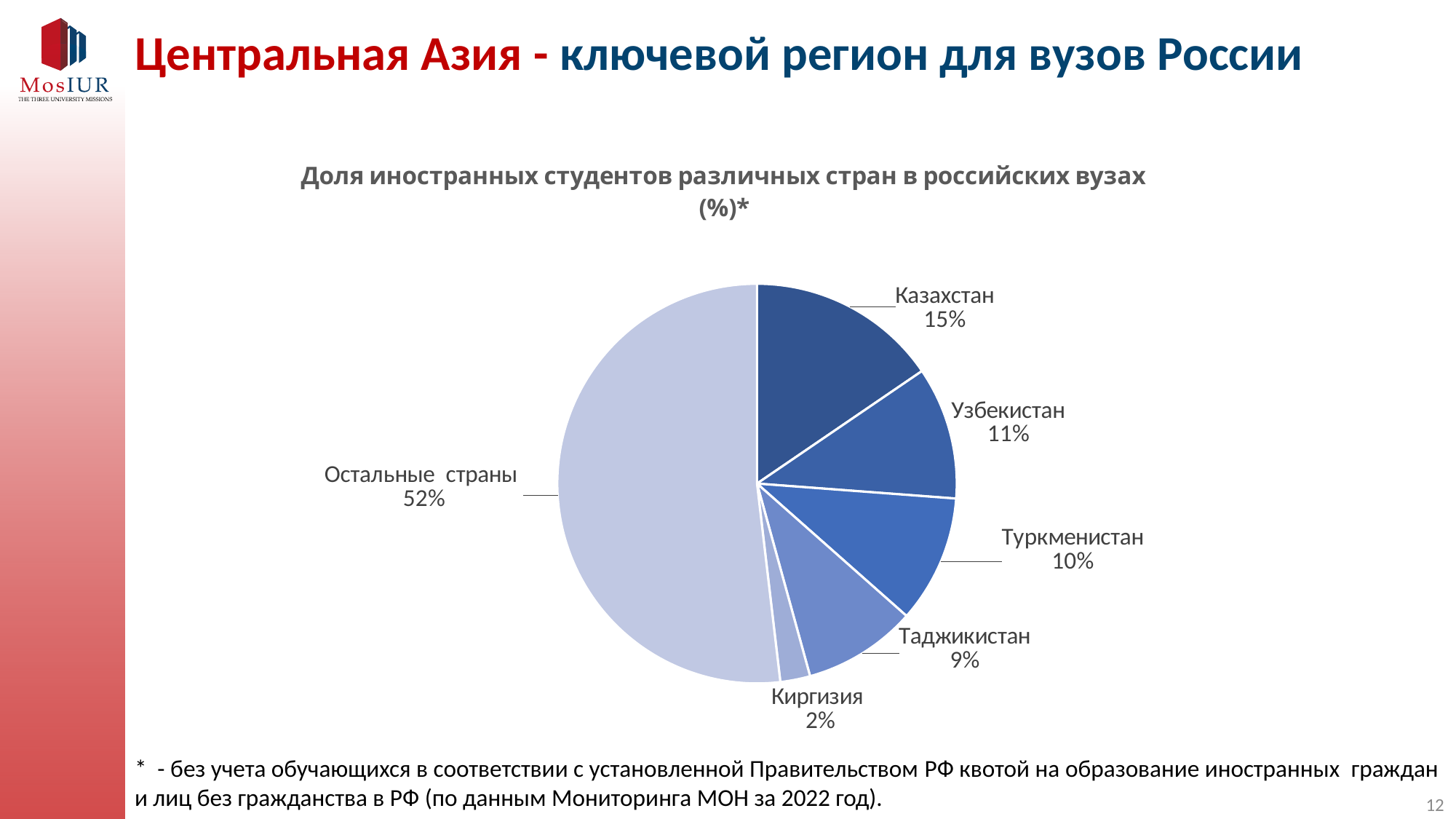
What is the value shown for Туркменистан? 10% Which category has the largest slice of the pie? Остальные страны What kind of chart is shown on the slide? Pie chart How many slices does the pie chart have? 6 Which category has the smallest slice of the pie? Киргизия Which is larger, the share of Узбекистан or the share of Туркменистан? Узбекистан What is the title of the chart? Доля иностранных студентов различных стран в российских вузах (%)* What is the combined share of Казахстан and Узбекистан? 26% What is the value shown for Киргизия? 2% What is the difference between the shares of Казахстан and Таджикистан? 6% What share of the pie does Казахстан have? 15% What is the value shown for Узбекистан? 11%